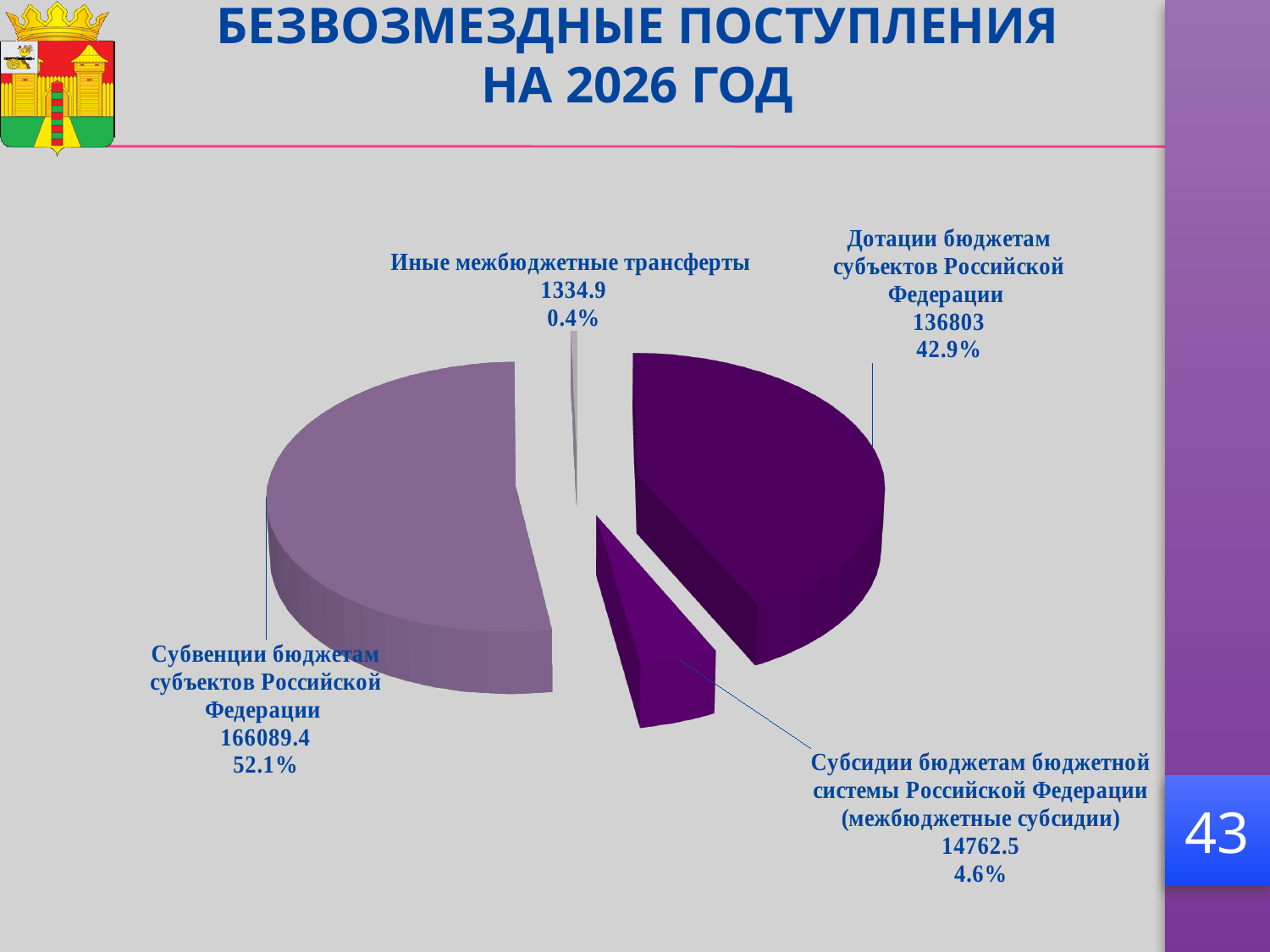
How many slices does the pie chart have? 4 What kind of chart is shown on the slide? Pie chart What is the value for Субвенции бюджетам субъектов Российской Федерации? 166089.4 What share of the pie does Иные межбюджетные трансферты represent? 0.4% What is the value for Субсидии бюджетам бюджетной системы Российской Федерации (межбюджетные субсидии)? 14762.5 What is the value for Дотации бюджетам субъектов Российской Федерации? 136803 What is the value for Иные межбюджетные трансферты? 1334.9 What is the difference between the values for Субвенции бюджетам субъектов Российской Федерации and Дотации бюджетам субъектов Российской Федерации? 29286.4 Which category has the largest slice? Субвенции бюджетам субъектов Российской Федерации Which category has the smallest slice? Иные межбюджетные трансферты What is the title of the slide containing the chart? БЕЗВОЗМЕЗДНЫЕ ПОСТУПЛЕНИЯ НА 2026 ГОД What share of the pie does Дотации бюджетам субъектов Российской Федерации represent? 42.9%